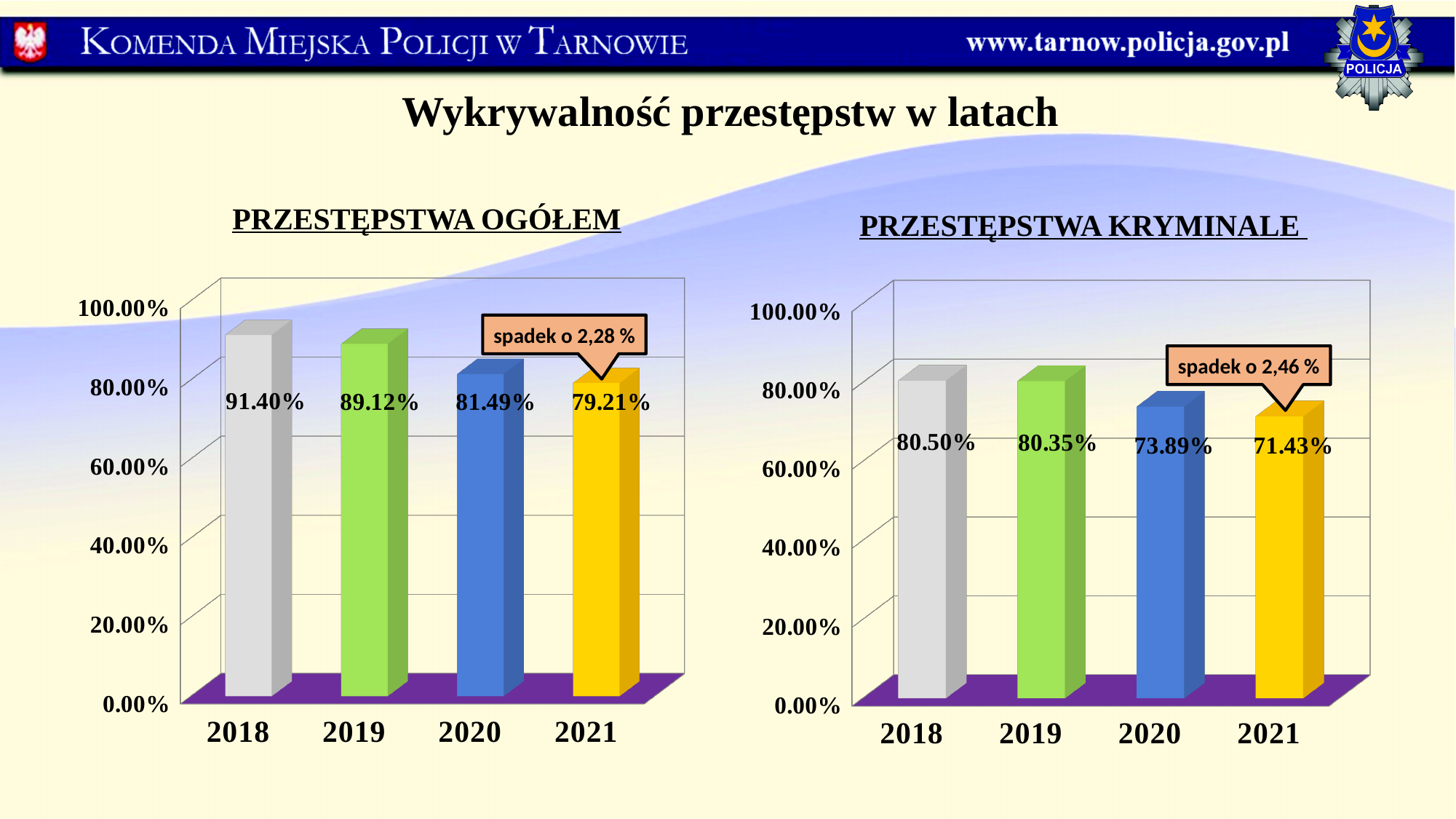
In the PRZESTĘPSTWA OGÓŁEM chart, what is the difference between the 2018 and 2021 values? 12.19% In the PRZESTĘPSTWA OGÓŁEM chart, what is the value for 2018? 91.40% In the PRZESTĘPSTWA OGÓŁEM chart, do the values rise or fall from 2018 to 2021? fall In the PRZESTĘPSTWA KRYMINALNE chart, what is the value for 2020? 73.89% In the PRZESTĘPSTWA KRYMINALNE chart, which year has the highest value? 2018 How many years are shown on the x axis of the PRZESTĘPSTWA OGÓŁEM chart? 4 In the PRZESTĘPSTWA KRYMINALNE chart, what is the difference between the 2020 and 2021 values? 2.46% In the PRZESTĘPSTWA KRYMINALNE chart, is the value for 2021 greater or less than 80.00%? less What does the callout above the 2021 bar in the PRZESTĘPSTWA OGÓŁEM chart say? spadek o 2,28 % What kind of chart is the PRZESTĘPSTWA KRYMINALNE chart? bar chart In the PRZESTĘPSTWA OGÓŁEM chart, which year has the lowest value? 2021 In the PRZESTĘPSTWA OGÓŁEM chart, which is larger, the value for 2019 or the value for 2020? 2019